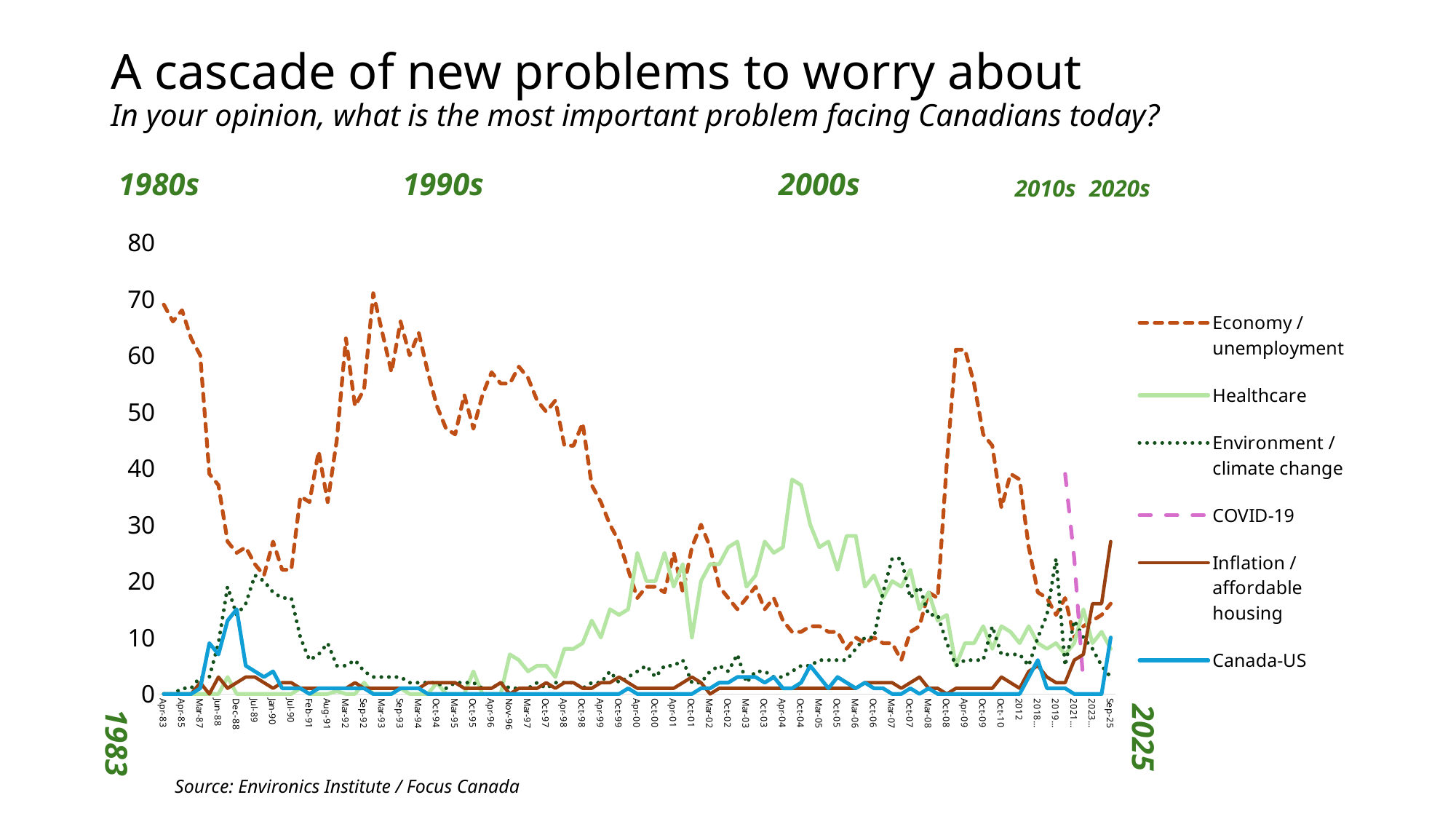
Is the value for Inflation / affordable housing at Sep-25 greater or less than 20? greater What kind of chart is shown on the slide? line chart Is the value for Economy / unemployment at Apr-83 greater or less than 60? greater How many series does the legend list? 6 At Sep-25, which is larger: Inflation / affordable housing or Economy / unemployment? Inflation / affordable housing Is the peak value of the Healthcare series greater or less than 30? greater Which series has the highest value at the start of the chart (Apr-83)? Economy / unemployment Does the Inflation / affordable housing series rise or fall between 2021 and Sep-25? rise Does the Economy / unemployment series rise or fall between Apr-83 and Jun-88? fall Which series reaches the highest value anywhere on the chart? Economy / unemployment What is the source cited for the chart? Environics Institute / Focus Canada